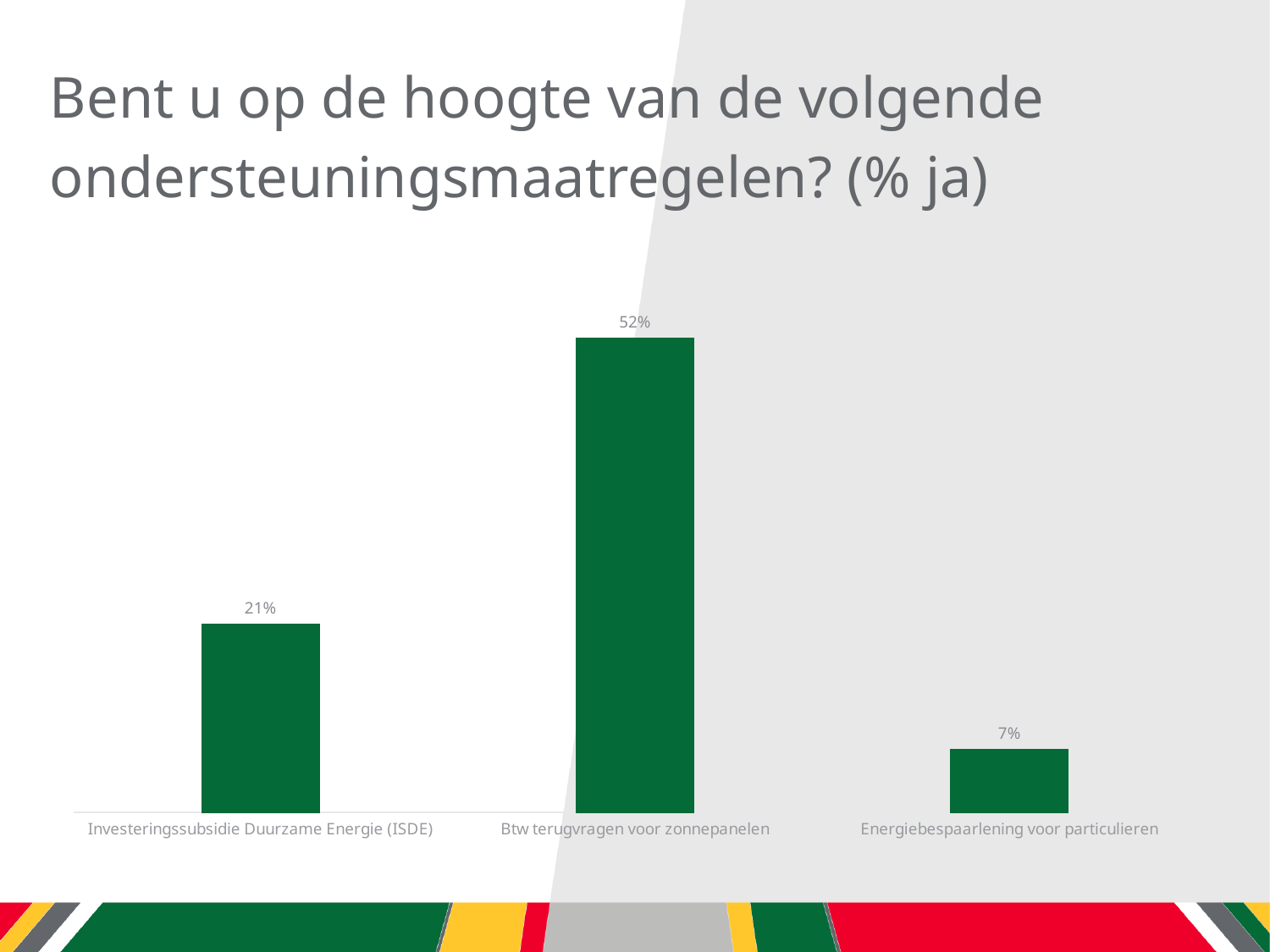
What colour are the bars in the chart? Green What percentage of respondents are aware of the Investeringssubsidie Duurzame Energie (ISDE)? 21% How many support measures are shown in the chart? 3 What is the title of the slide? Bent u op de hoogte van de volgende ondersteuningsmaatregelen? (% ja) What is the value shown for Energiebespaarlening voor particulieren? 7% What is the difference between the values for Investeringssubsidie Duurzame Energie (ISDE) and Energiebespaarlening voor particulieren? 14% What type of chart is shown on the slide? Bar chart Which support measure has the highest awareness percentage? Btw terugvragen voor zonnepanelen What is the value shown for Btw terugvragen voor zonnepanelen? 52% Which is larger: the value for Investeringssubsidie Duurzame Energie (ISDE) or for Energiebespaarlening voor particulieren? Investeringssubsidie Duurzame Energie (ISDE) Which support measure has the lowest awareness percentage? Energiebespaarlening voor particulieren What is the difference between the values for Btw terugvragen voor zonnepanelen and Investeringssubsidie Duurzame Energie (ISDE)? 31%